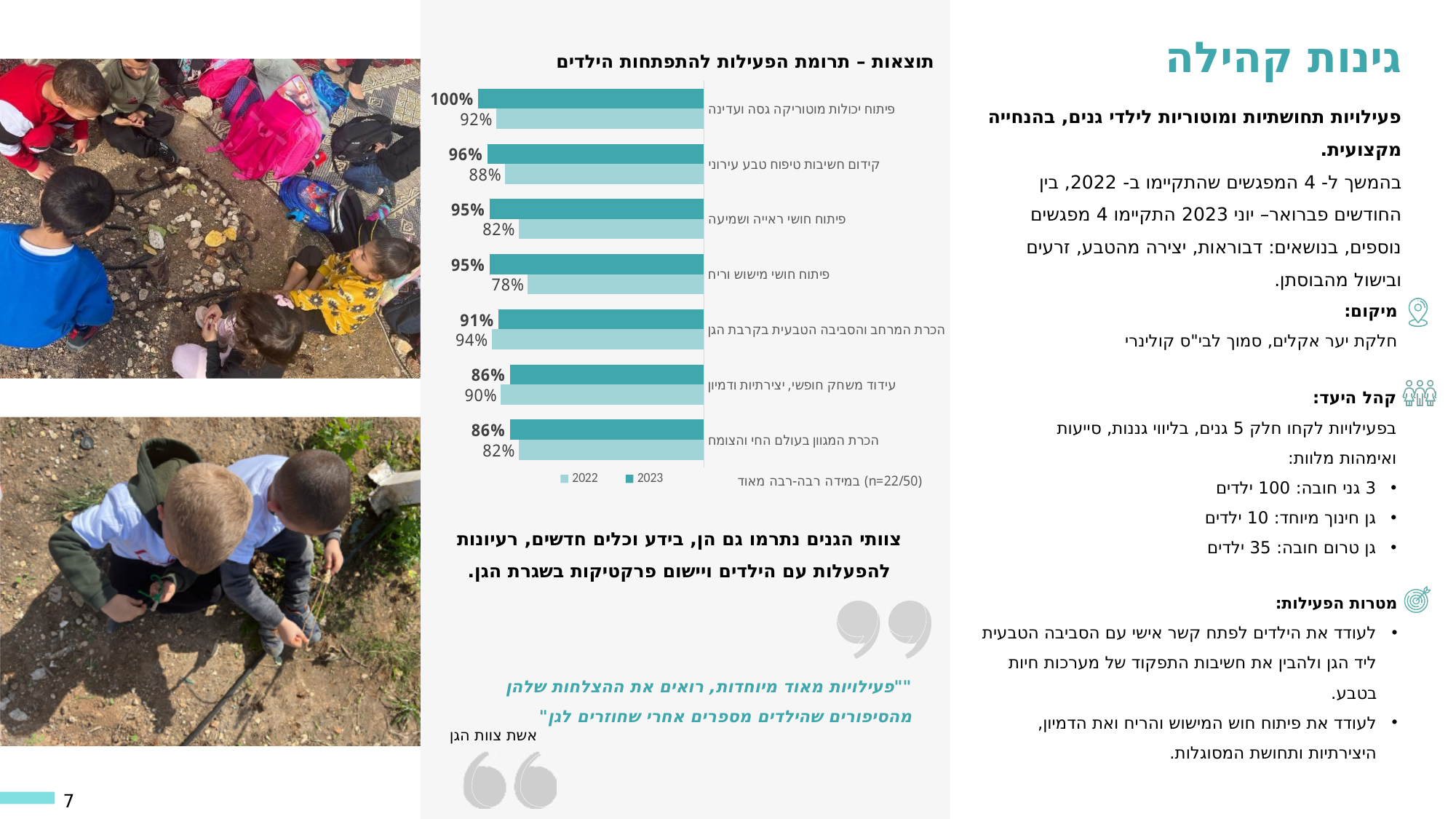
How many categories are shown in the chart? 7 What is the 2023 value for פיתוח יכולות מוטוריקה גסה ועדינה? 100% What is the title of the chart? תוצאות – תרומת הפעילות להתפתחות הילדים What is the 2022 value for הכרת המרחב והסביבה הטבעית בקרבת הגן? 94% What is the 2022 value for פיתוח חושי מישוש וריח? 78% Which category has the highest 2023 value? פיתוח יכולות מוטוריקה גסה ועדינה For עידוד משחק חופשי, יצירתיות ודמיון, which year has the larger value, 2022 or 2023? 2022 What is the difference between the 2023 and 2022 values for פיתוח חושי ראייה ושמיעה? 13% What is the 2023 value for קידום חשיבות טיפוח טבע עירוני? 96% Which category has the lowest 2022 value? פיתוח חושי מישוש וריח How many series does the chart legend list? 2 What type of chart is shown on the slide? bar chart